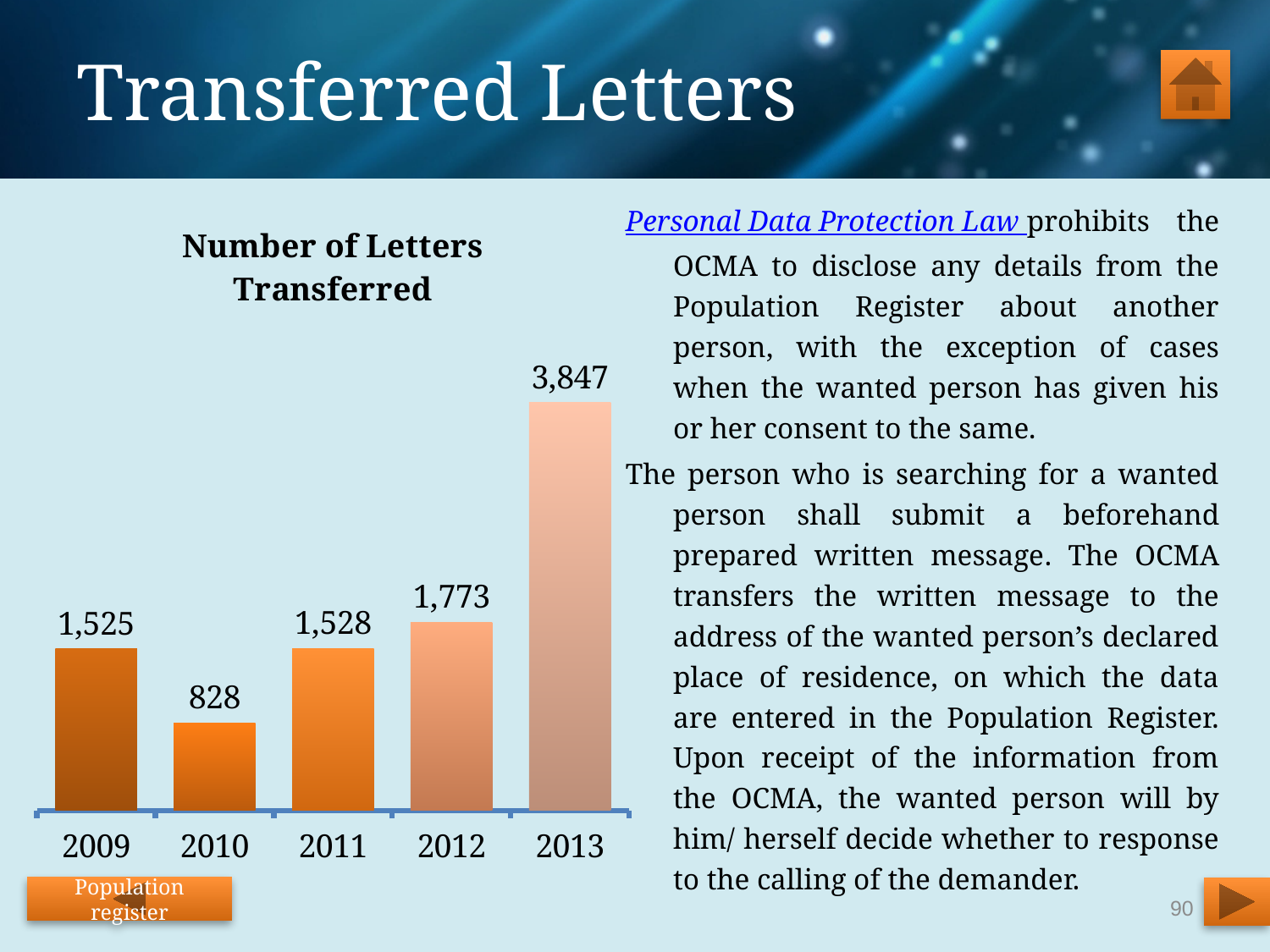
Which year had more letters transferred, 2010 or 2012? 2012 Did the number of letters transferred rise or fall from 2010 to 2013? Rise What is the number of letters transferred in 2012? 1,773 What is the title of the chart? Number of Letters Transferred Which year has the highest number of letters transferred? 2013 What is the difference between the number of letters transferred in 2011 and in 2009? 3 What is the number of letters transferred in 2010? 828 What is the difference between the number of letters transferred in 2013 and in 2012? 2,074 What kind of chart is shown on the slide? Bar chart Which year has the lowest number of letters transferred? 2010 What is the number of letters transferred in 2013? 3,847 How many years are shown on the chart? 5